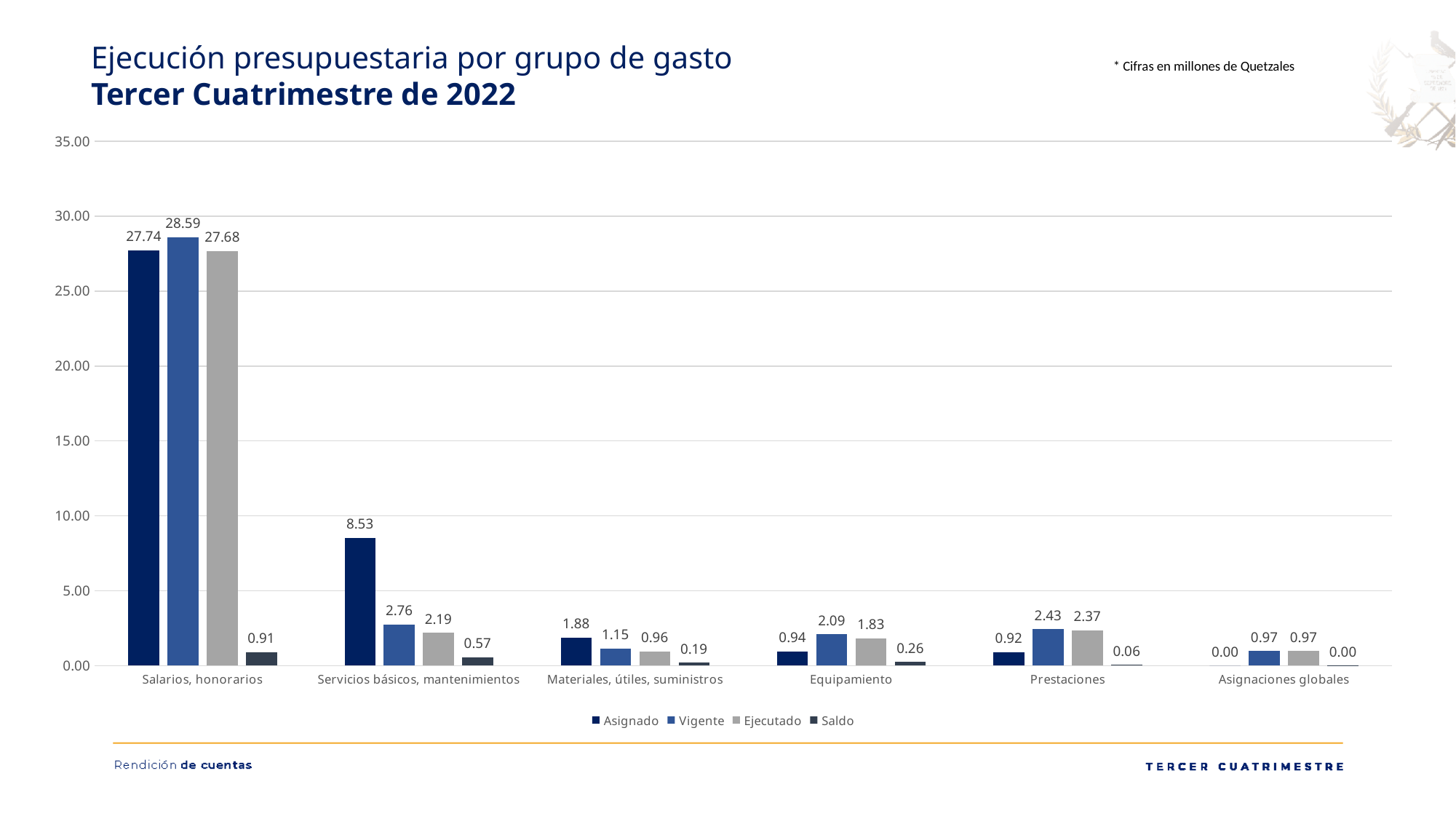
Which category has the highest Ejecutado value? Salarios, honorarios Which category has the lowest Asignado value? Asignaciones globales What is the Vigente value for Salarios, honorarios? 28.59 What kind of chart is shown on the slide? Bar chart Which is larger for Materiales, útiles, suministros: the Asignado value or the Vigente value? Asignado What is the Saldo value for Equipamiento? 0.26 How many categories are shown on the x axis? 6 What is the Asignado value for Servicios básicos, mantenimientos? 8.53 What is the Ejecutado value for Prestaciones? 2.37 How many series does the legend list? 4 What is the difference between the Vigente and Ejecutado values for Salarios, honorarios? 0.91 Is the Asignado value for Servicios básicos, mantenimientos greater or less than 10.00? less